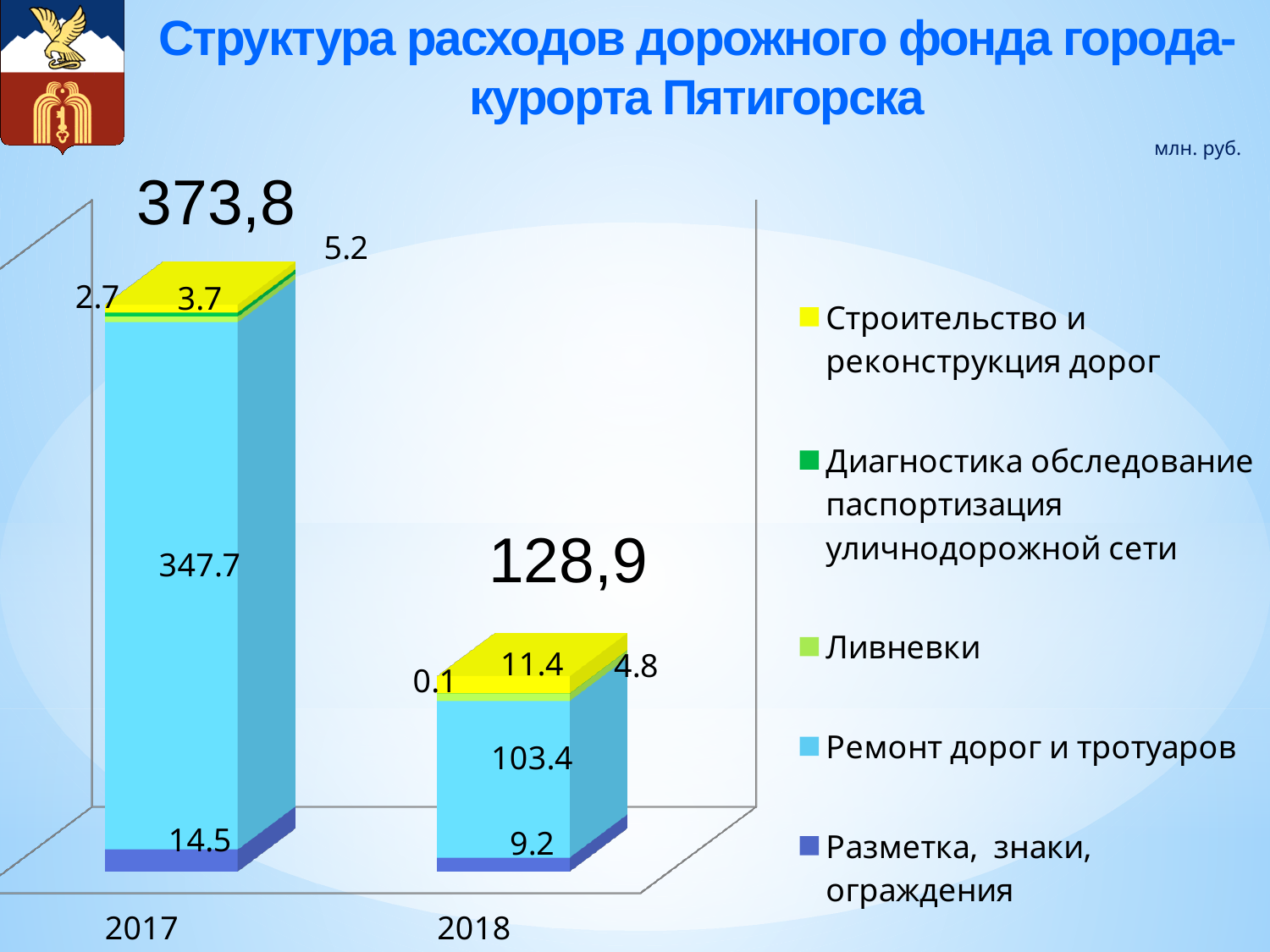
What is the value for Разметка, знаки, ограждения in 2017? 14.5 What kind of chart is shown on the slide? Stacked bar chart What is the total of the stacked bar for 2017? 373,8 What is the value for Разметка, знаки, ограждения in 2018? 9.2 What is the total of the stacked bar for 2018? 128,9 What is the value for Строительство и реконструкция дорог in 2018? 11.4 What is the value for Ремонт дорог и тротуаров in 2017? 347.7 What is the difference between the Ремонт дорог и тротуаров values for 2017 and 2018? 244.3 Which year has the larger total, 2017 or 2018? 2017 How many years are shown on the x axis? 2 What is the value for Ремонт дорог и тротуаров in 2018? 103.4 How many series does the legend list? 5